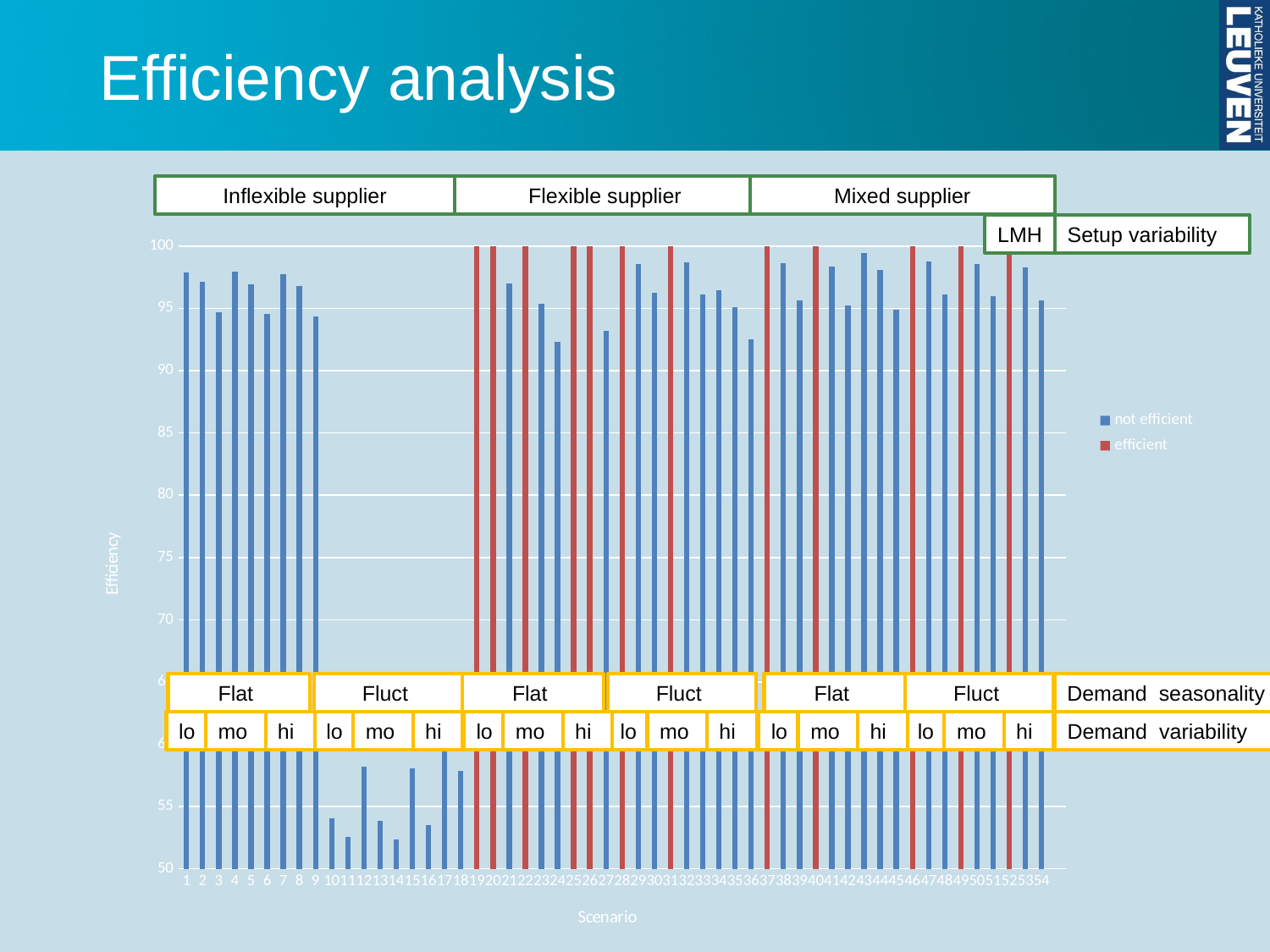
Which has the higher efficiency, scenario 24 or scenario 28? scenario 28 Is the value for scenario 1 greater or less than 95? greater Is the value for scenario 11 greater or less than 55? less How many scenarios are plotted along the x axis? 54 What is the efficiency value for scenario 19? 100 Which colour represents the 'efficient' series in the legend? red Is the value for scenario 36 greater or less than 95? less How many series does the legend list? 2 What kind of chart is shown on the slide? bar chart Which has the higher efficiency, scenario 1 or scenario 10? scenario 1 What is the title of the y axis? Efficiency